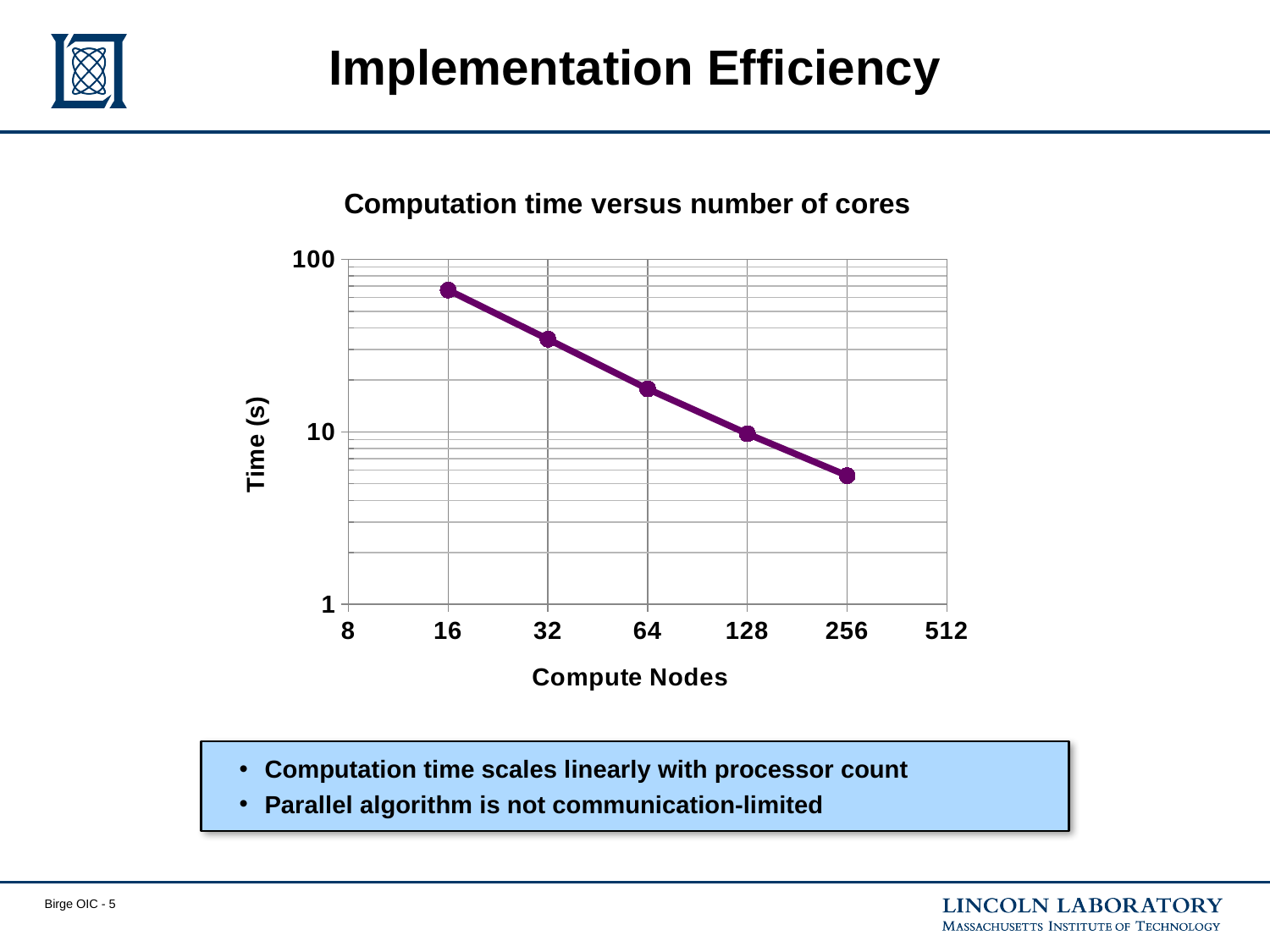
Is the computation time at 16 compute nodes greater or less than 100 seconds? less What is the label of the vertical axis? Time (s) Is the computation time at 16 compute nodes greater or less than 10 seconds? greater Is the computation time at 64 compute nodes greater or less than 10 seconds? greater What is the title of the chart? Computation time versus number of cores Does the computation time rise or fall as the number of compute nodes increases? fall How many data points are plotted on the line? 5 Which has the larger computation time, 32 compute nodes or 128 compute nodes? 32 compute nodes What kind of chart is shown on the slide? line chart At which number of compute nodes is the computation time highest? 16 At which number of compute nodes is the computation time lowest? 256